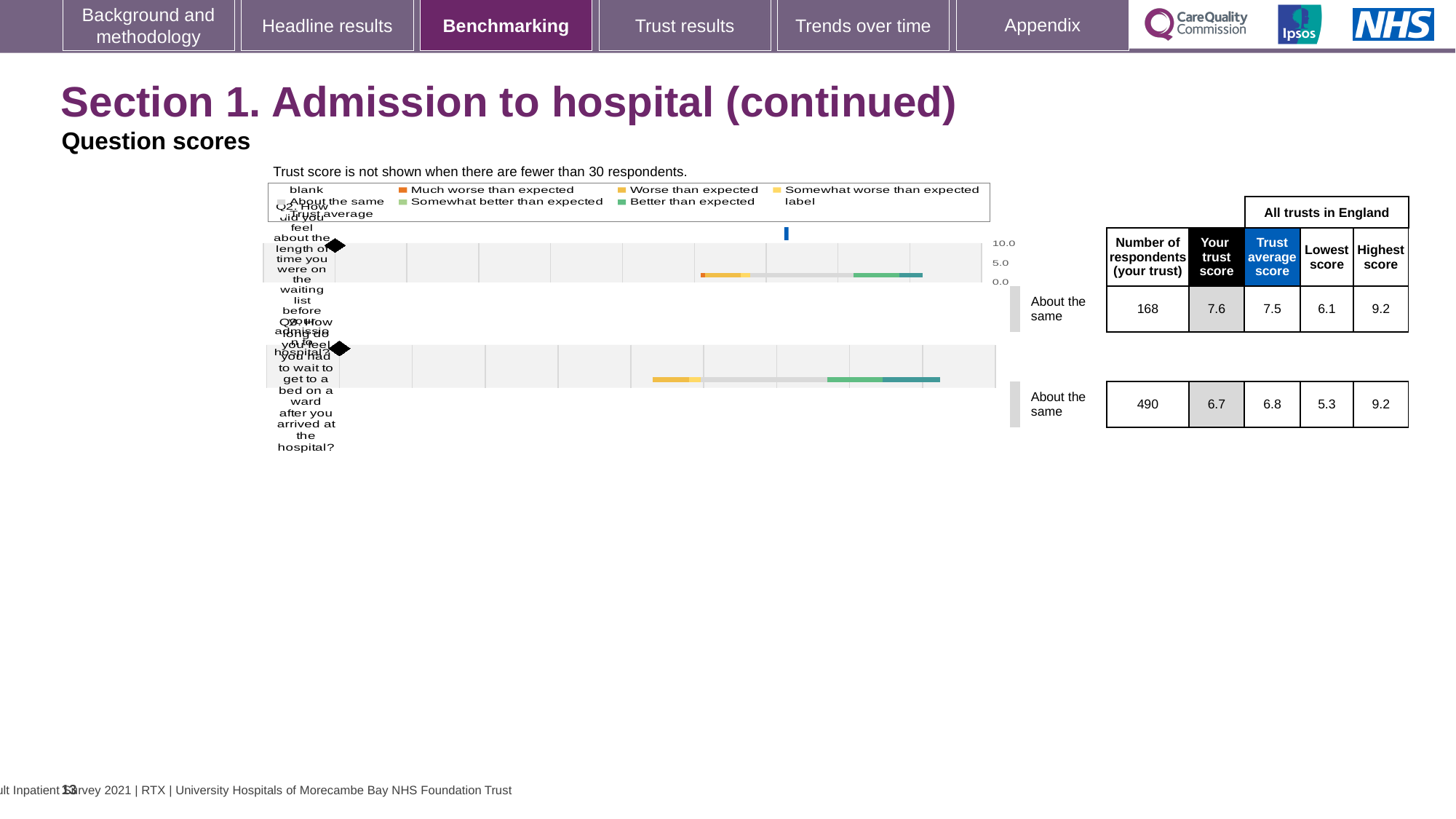
What is the trust average score for Q3? 6.8 How many respondents from your trust answered Q2? 168 What kind of chart is used to show the question scores on this slide? bar chart What is the difference between the 'Your trust score' and the trust average score for Q2? 0.1 What is the 'Your trust score' value for Q2 (how did you feel about the length of time on the waiting list)? 7.6 Is the 'Your trust score' for Q2 greater or less than 5.0 on the chart axis? greater How many questions (Q2 and Q3) are plotted on the slide? 2 How many respondents from your trust answered Q3? 490 What benchmark category is shown next to the Q3 chart? About the same What is the 'Your trust score' value for Q3 (how long did you feel you had to wait to get to a bed on a ward)? 6.7 Which question has the higher 'Your trust score', Q2 or Q3? Q2 What is the difference between the highest score and the lowest score for Q3? 3.9